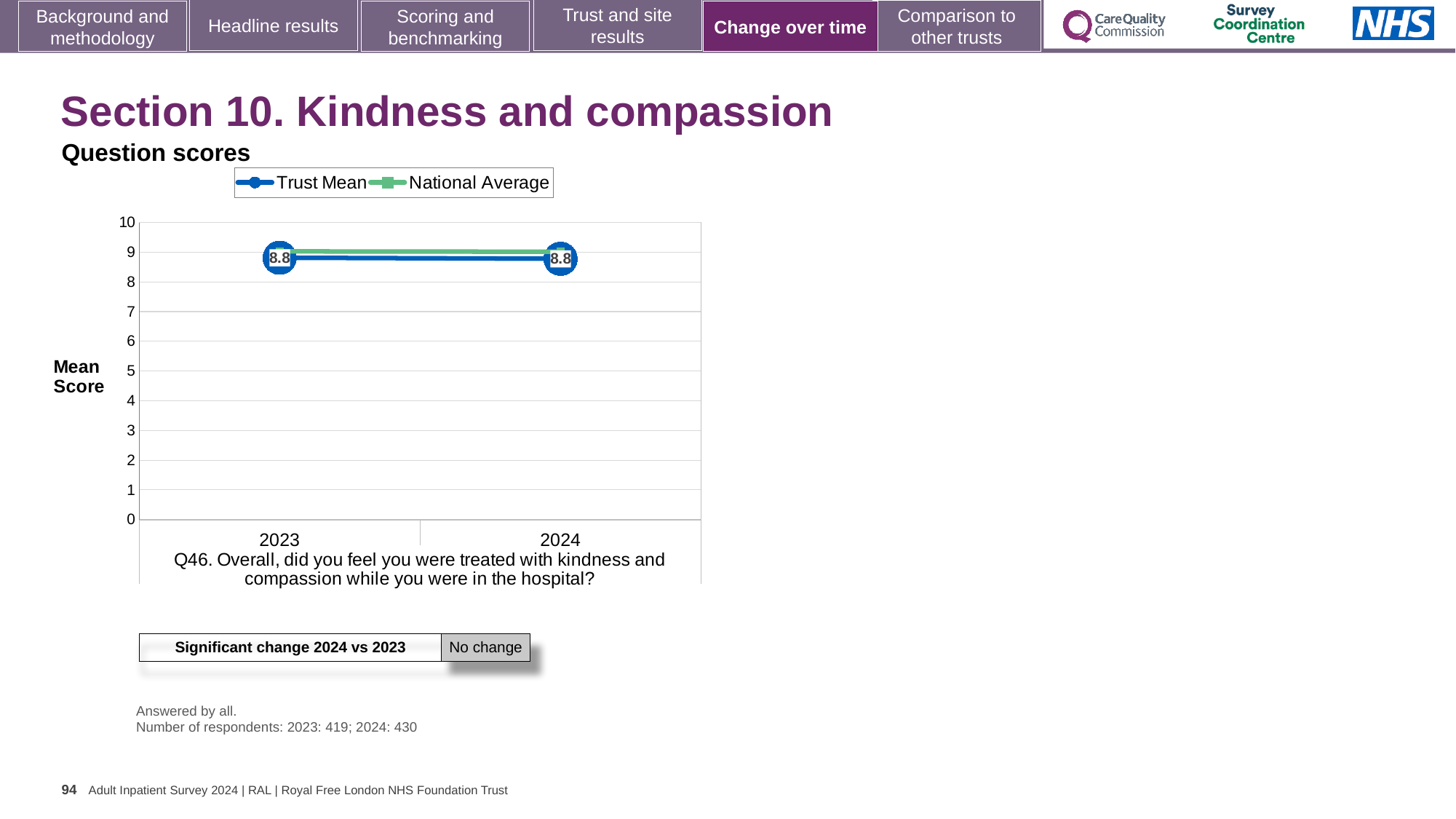
What are the two series named in the chart legend? Trust Mean and National Average What is the Trust Mean score for 2024? 8.8 How many series does the chart legend list? 2 Is the Trust Mean score for 2024 greater or less than 8? greater Is the National Average for 2023 greater or less than 5? greater What is the label on the y axis of the chart? Mean Score What kind of chart is shown on the slide? Line chart How many years are plotted on the x axis of the chart? 2 What is the maximum value shown on the y axis of the chart? 10 What is the Trust Mean score for 2023? 8.8 Does the Trust Mean rise, fall or stay the same from 2023 to 2024? Stays the same What is the difference between the Trust Mean scores for 2024 and 2023? 0